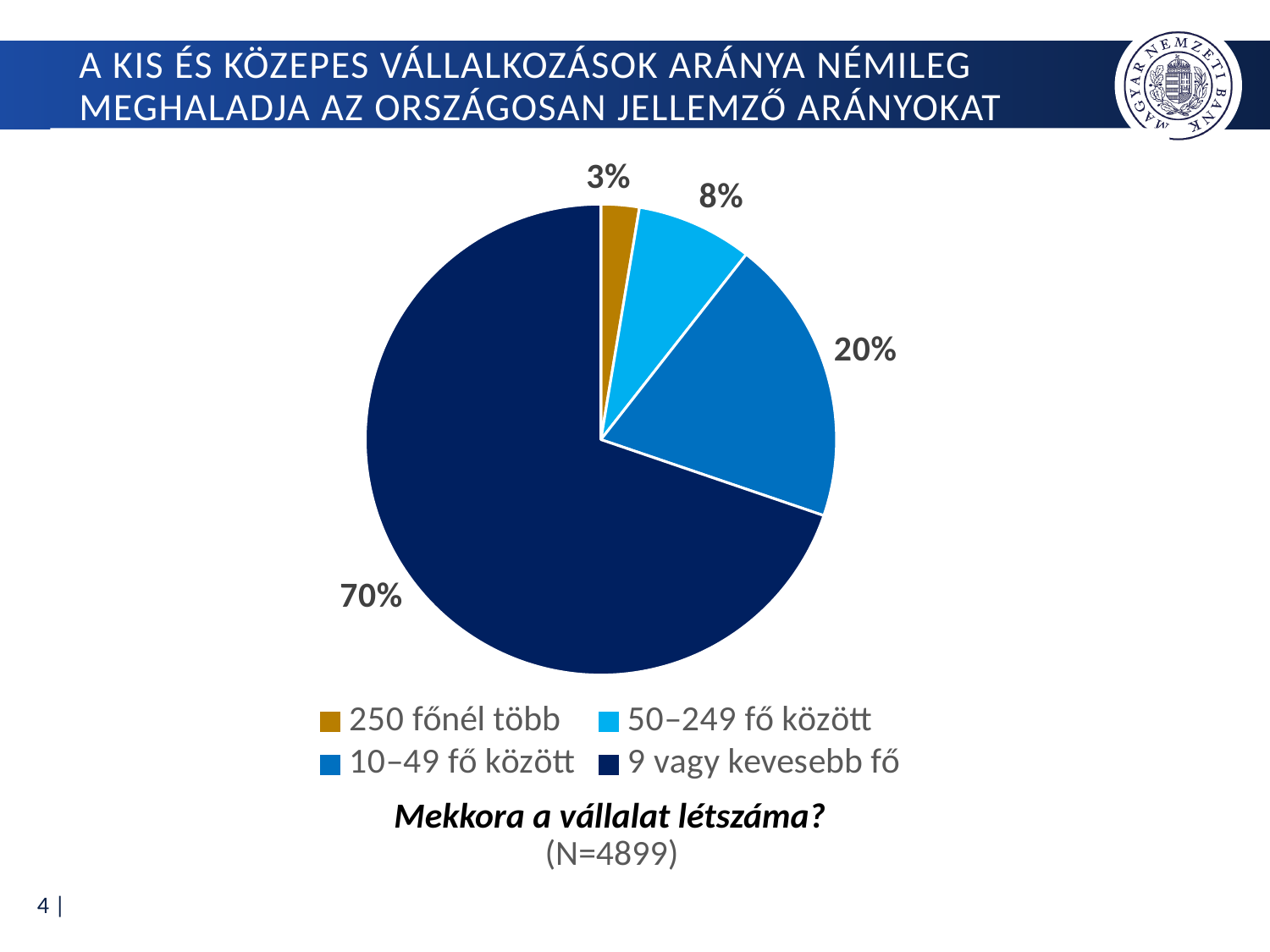
What is the value for "50–249 fő között"? 8% Which category has the largest slice of the pie? 9 vagy kevesebb fő What is the difference between the values for "9 vagy kevesebb fő" and "10–49 fő között"? 50% What is the value for "250 főnél több"? 3% What is the value for "10–49 fő között"? 20% How many categories does the pie chart have? 4 Which category has the smallest slice of the pie? 250 főnél több Which is larger: the value for "10–49 fő között" or the value for "50–249 fő között"? 10–49 fő között What type of chart is shown on the slide? pie chart What is the sample size (N) shown below the chart? N=4899 What is the difference between the values for "50–249 fő között" and "250 főnél több"? 5% What share of the pie does the "9 vagy kevesebb fő" slice represent? 70%